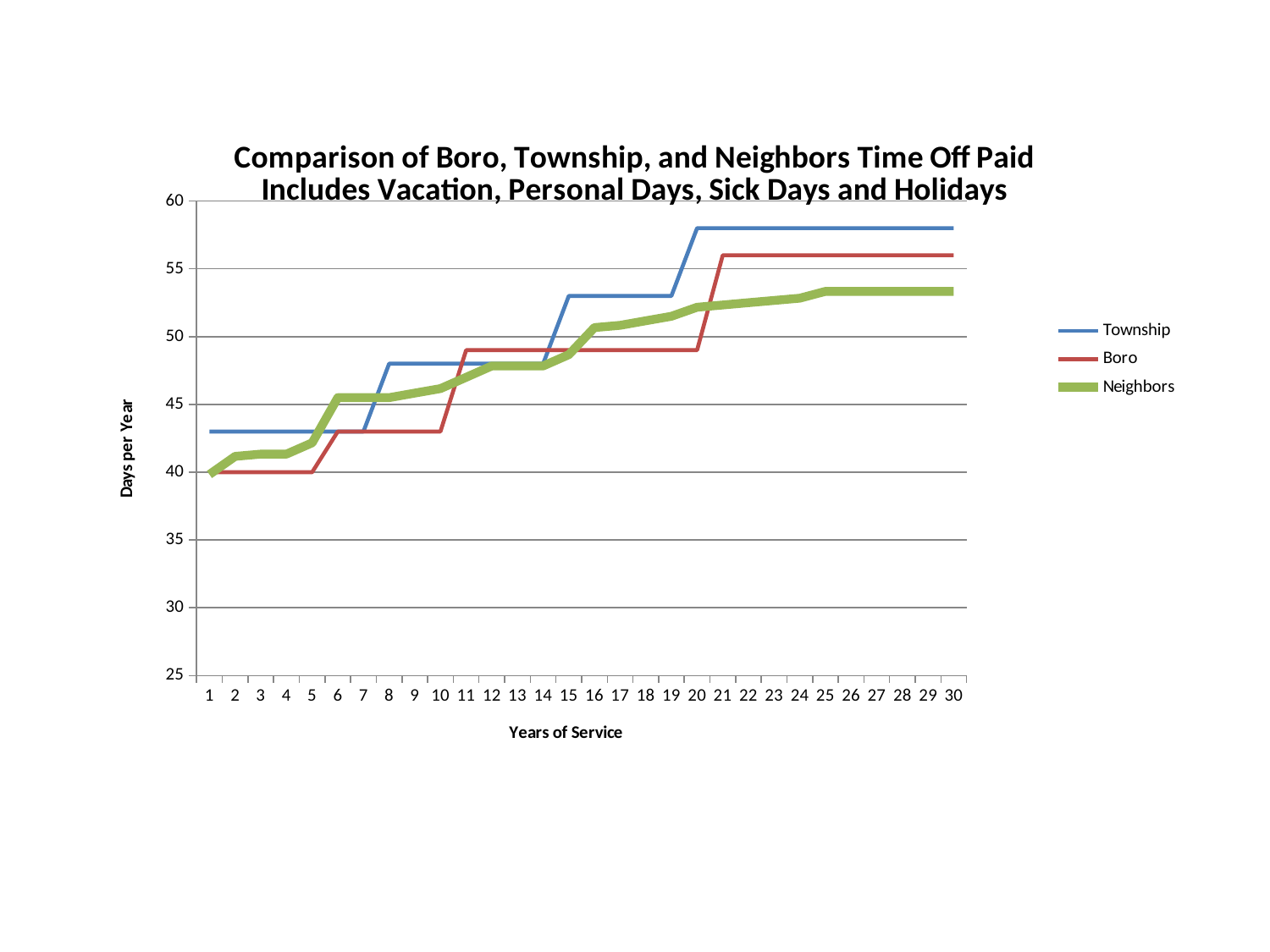
What kind of chart is shown on the slide? line chart Is the value for Township at year 1 greater or less than 45? less Is the value for Township at year 30 greater or less than 55? greater How many years of service are shown along the x axis? 30 What is the value for Boro at year 1 of service? 40 Do the Township values rise or fall as years of service increase? rise Which series has the lowest value at year 30 of service? Neighbors How many series does the legend list? 3 Which series has the highest value at year 30 of service? Township At year 6 of service, which is larger, Neighbors or Township? Neighbors At year 10 of service, which is larger, Township or Boro? Township Is the value for Neighbors at year 30 greater or less than 55? less